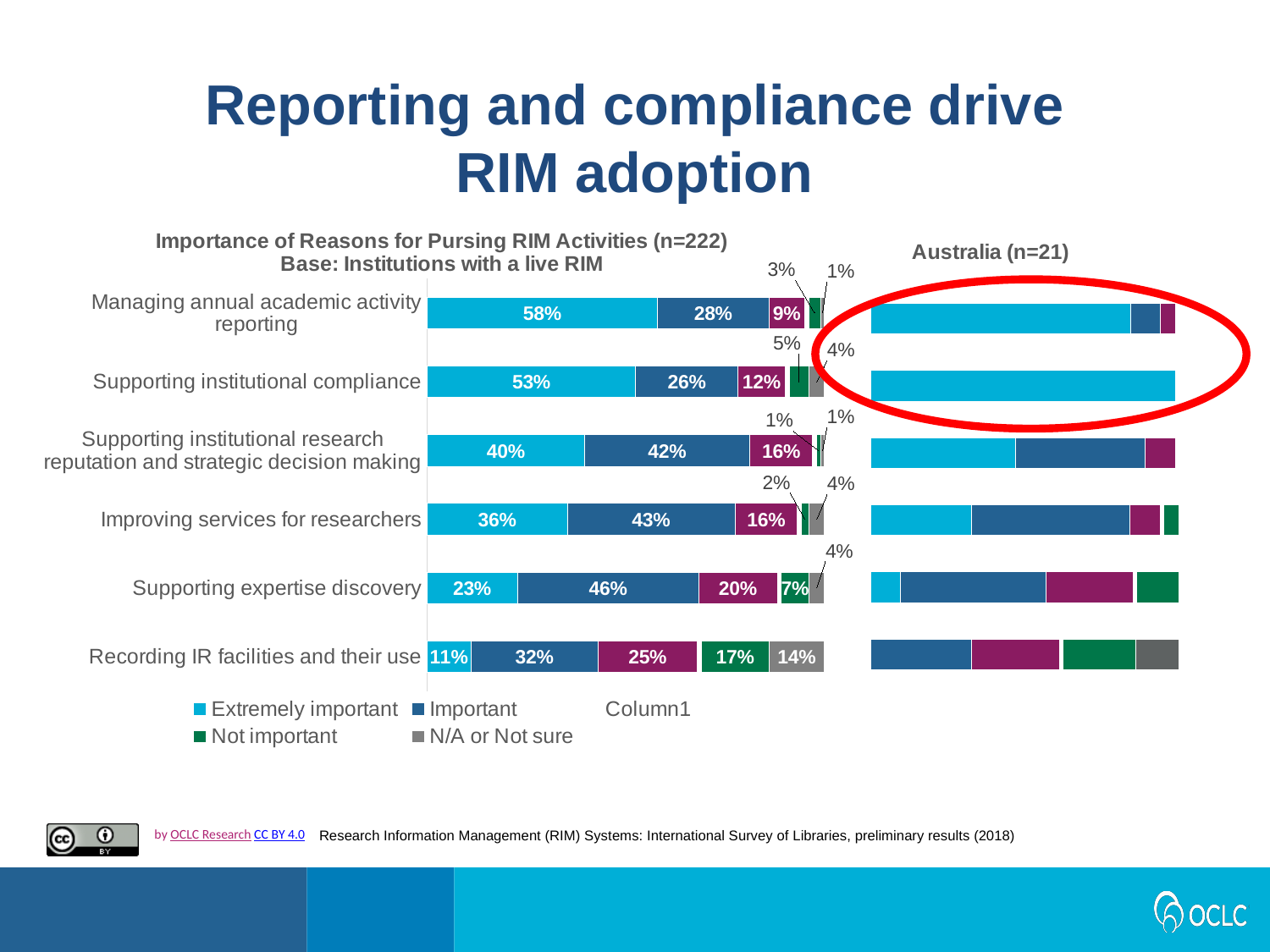
In the 'Importance of Reasons for Pursing RIM Activities (n=222)' chart, what is the 'Not important' value for 'Recording IR facilities and their use'? 17% In the 'Importance of Reasons for Pursing RIM Activities (n=222)' chart, which reason has the lowest 'Extremely important' percentage? Recording IR facilities and their use In the 'Importance of Reasons for Pursing RIM Activities (n=222)' chart, which has the larger 'Important' value: 'Supporting expertise discovery' or 'Recording IR facilities and their use'? Supporting expertise discovery In the 'Importance of Reasons for Pursing RIM Activities (n=222)' chart, what percentage rated 'Supporting expertise discovery' as Important? 46% What is the title of the chart on the right side of the slide? Australia (n=21) In the 'Importance of Reasons for Pursing RIM Activities (n=222)' chart, what percentage rated 'Managing annual academic activity reporting' as Extremely important? 58% In the 'Importance of Reasons for Pursing RIM Activities (n=222)' chart, do the 'Extremely important' values rise or fall going from the top category to the bottom category? Fall In the 'Importance of Reasons for Pursing RIM Activities (n=222)' chart, which reason has the highest 'Extremely important' percentage? Managing annual academic activity reporting What kind of chart is the 'Importance of Reasons for Pursing RIM Activities (n=222)' chart? Stacked bar chart How many reasons (categories) are listed in the 'Importance of Reasons for Pursing RIM Activities (n=222)' chart? 6 In the 'Importance of Reasons for Pursing RIM Activities (n=222)' chart, what is the difference between the 'Extremely important' values for 'Managing annual academic activity reporting' and 'Supporting institutional compliance'? 5 percentage points In the 'Importance of Reasons for Pursing RIM Activities (n=222)' chart, what is the 'N/A or Not sure' value for 'Recording IR facilities and their use'? 14%